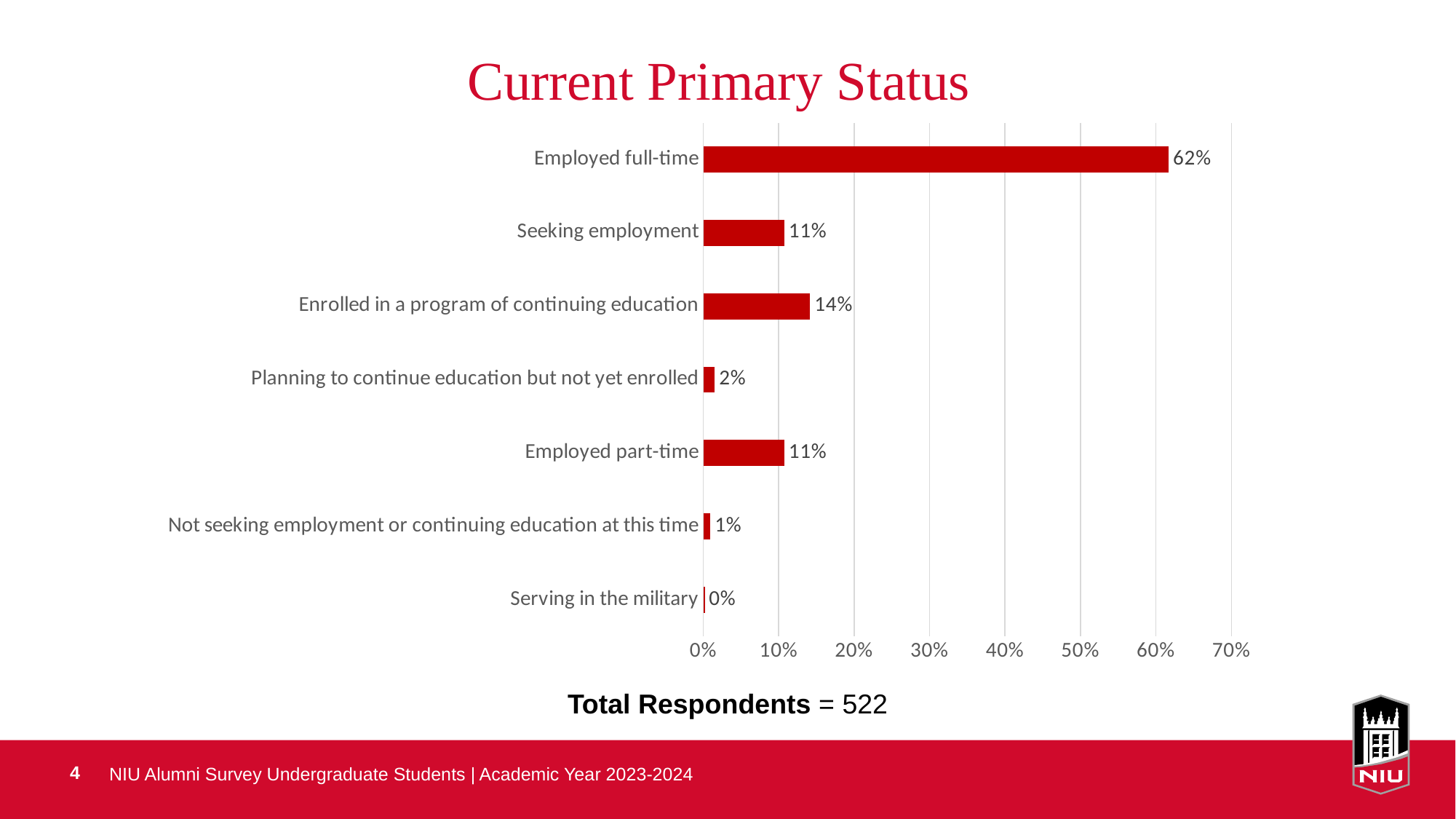
What is the value for 'Serving in the military'? 0% What is the title of the chart? Current Primary Status Which category has the lowest value? Serving in the military What kind of chart is shown on the slide? Bar chart How many categories are shown in the chart? 7 What percentage of respondents are planning to continue education but not yet enrolled? 2% Which is larger: the value for 'Enrolled in a program of continuing education' or the value for 'Seeking employment'? Enrolled in a program of continuing education Is the value for 'Employed full-time' greater or less than 60%? greater What percentage of respondents are employed full-time? 62% Which category has the highest value? Employed full-time What is the value for 'Enrolled in a program of continuing education'? 14% What is the difference between the values for 'Employed full-time' and 'Enrolled in a program of continuing education'? 48%